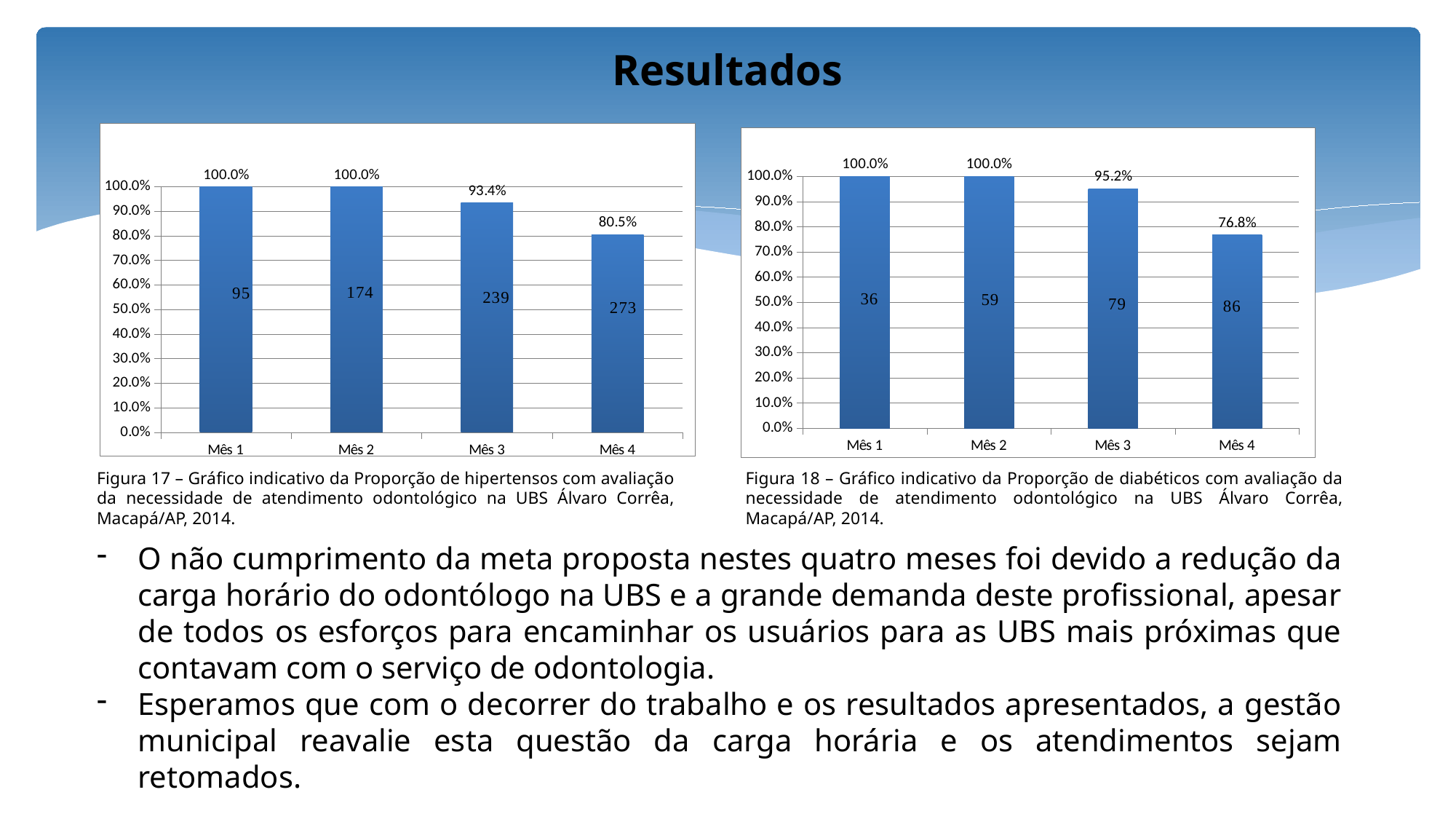
In the left chart (Figura 17, hipertensos), do the percentage values rise or fall from Mês 2 to Mês 4? Fall Which is larger: the Mês 4 percentage in the left chart (Figura 17) or the Mês 4 percentage in the right chart (Figura 18)? Left chart (Figura 17), 80.5% In the right chart (Figura 18, diabéticos), what number is printed inside the bar for Mês 4? 86 In the right chart (Figura 18, diabéticos), which month has the lowest percentage? Mês 4 What type of chart is the right chart (Figura 18)? Bar chart In the right chart (Figura 18, diabéticos), what is the difference in percentage points between Mês 1 and Mês 4? 23.2 In the left chart (Figura 17, hipertensos), what number is printed inside the bar for Mês 2? 174 In the left chart (Figura 17, hipertensos), what is the percentage value for Mês 4? 80.5% How many months (categories) are shown in the left chart (Figura 17)? 4 In the right chart (Figura 18, diabéticos), what is the percentage value for Mês 3? 95.2% In the left chart (Figura 17, hipertensos), what is the difference in percentage points between Mês 3 and Mês 4? 12.9 In the left chart (Figura 17, hipertensos), what is the percentage value for Mês 3? 93.4%